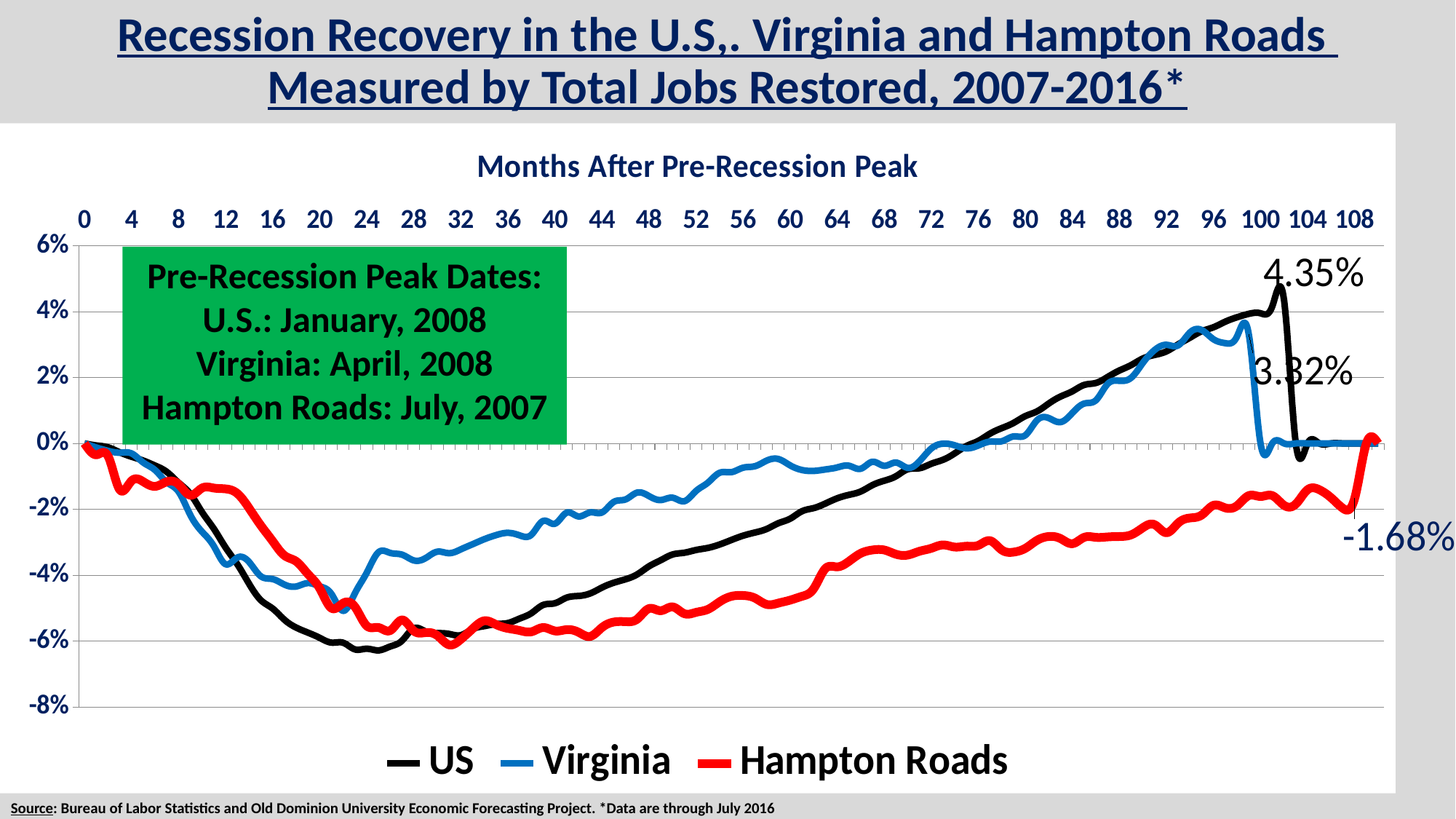
What is the labeled value at the end of the Hampton Roads line? -1.68% Which labeled peak is larger, the US at 4.35% or Virginia at 3.32%? US What is the labeled peak value of the US line? 4.35% What kind of chart is shown on the slide? line chart Does the US line rise or fall between month 24 and month 100? rise Is the value for Hampton Roads at month 40 greater or less than -4%? less How many series does the legend list? 3 Is the value for Virginia at month 60 greater or less than -2%? greater What is the difference between the labeled US peak (4.35%) and the labeled Virginia peak (3.32%)? 1.03 percentage points What is the labeled peak value of the Virginia line? 3.32% What are the three series named in the legend? US, Virginia, Hampton Roads What is the title of the x axis? Months After Pre-Recession Peak